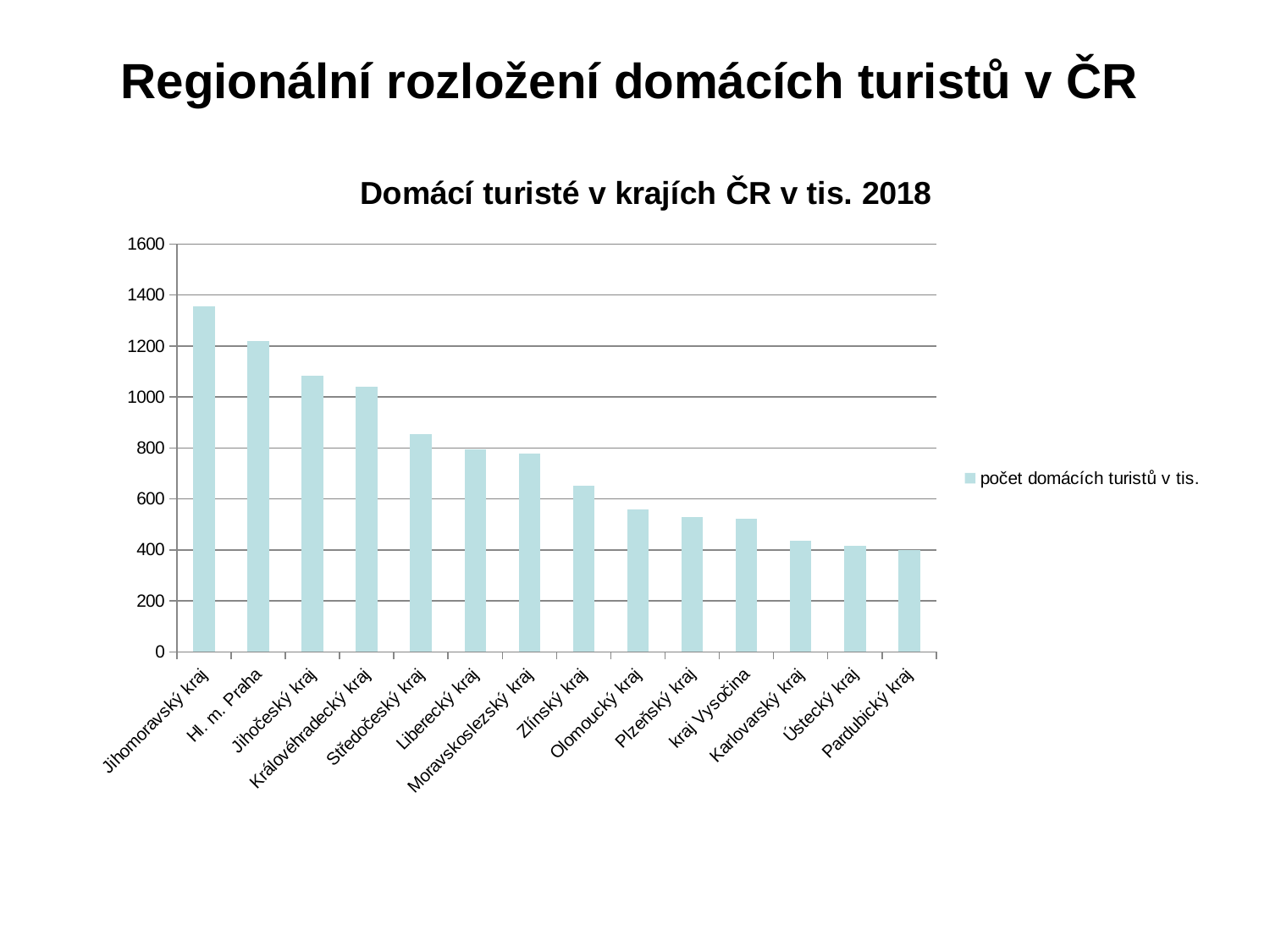
How many regions (categories) are plotted on the chart? 14 Is the value for Zlínský kraj greater or less than 600? greater What kind of chart is shown on the slide? bar chart Which has more domestic tourists, Jihočeský kraj or Olomoucký kraj? Jihočeský kraj Do the values rise or fall from left to right along the x axis? fall What is the title of the chart? Domácí turisté v krajích ČR v tis. 2018 Is the value for Hl. m. Praha greater or less than 1200? greater Is the value for Středočeský kraj greater or less than 800? greater Which region has the highest number of domestic tourists? Jihomoravský kraj Which region has the lowest number of domestic tourists? Pardubický kraj How many series does the legend list? 1